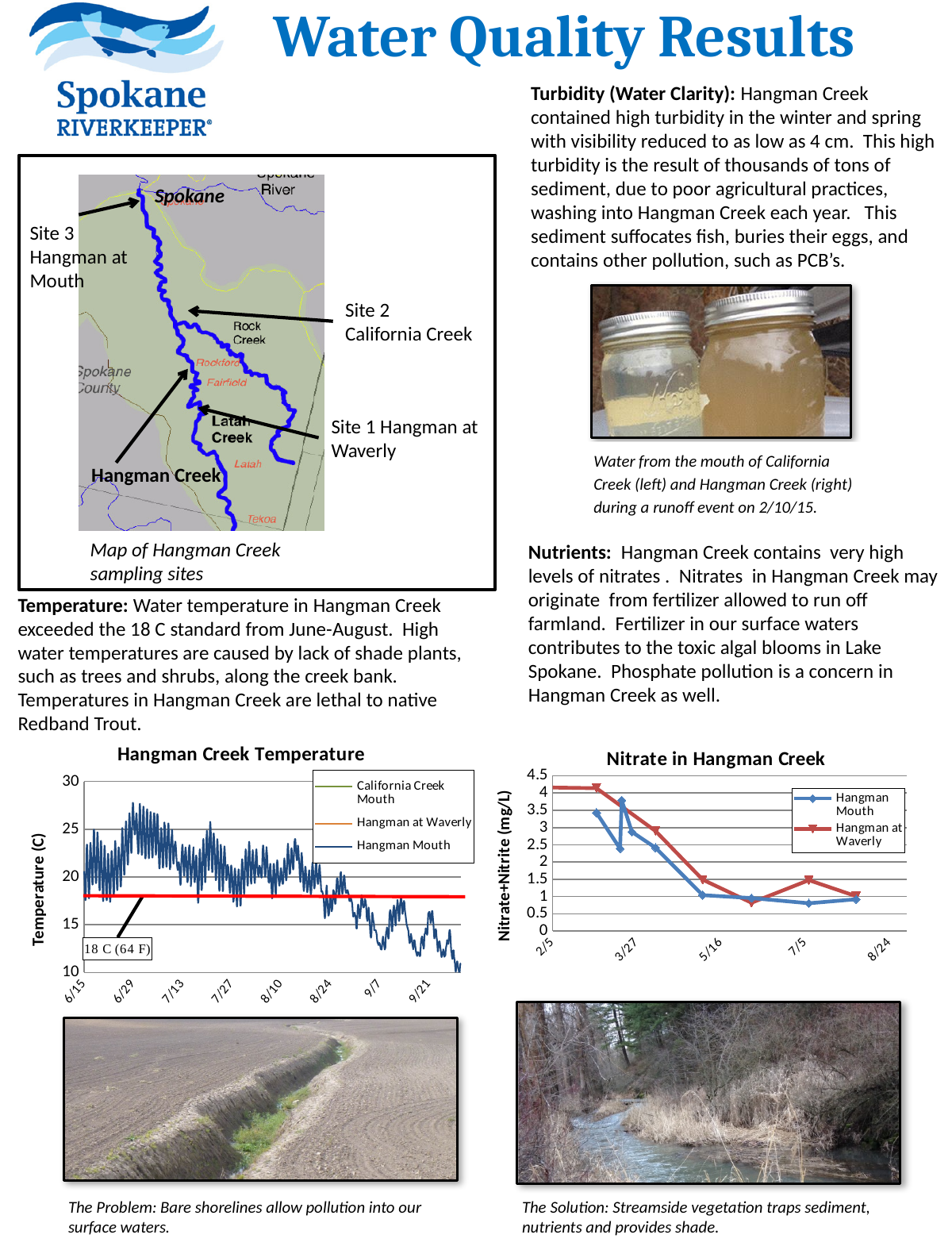
How many series does the legend of the "Nitrate in Hangman Creek" chart list? 2 In the "Nitrate in Hangman Creek" chart, is the Hangman Mouth value on 2/5 greater or less than 4? less How many series does the legend of the "Hangman Creek Temperature" chart list? 3 In the "Hangman Creek Temperature" chart, is the Hangman Mouth temperature around 9/21 greater or less than 15? less In the "Hangman Creek Temperature" chart, what temperature does the red horizontal reference line mark? 18 C (64 F) What kind of chart is the "Hangman Creek Temperature" chart? line chart What is the y-axis label of the "Nitrate in Hangman Creek" chart? Nitrate+Nitrite (mg/L) In the "Nitrate in Hangman Creek" chart, which series has the higher value on 7/5, Hangman Mouth or Hangman at Waverly? Hangman at Waverly What kind of chart is the "Nitrate in Hangman Creek" chart? line chart In the "Hangman Creek Temperature" chart, do the Hangman Mouth temperatures generally rise or fall from 8/24 to 9/21? fall In the "Nitrate in Hangman Creek" chart, do the Hangman at Waverly values rise or fall between 2/5 and 5/16? fall In the "Nitrate in Hangman Creek" chart, is the Hangman at Waverly value on 2/5 greater or less than 3.5? greater